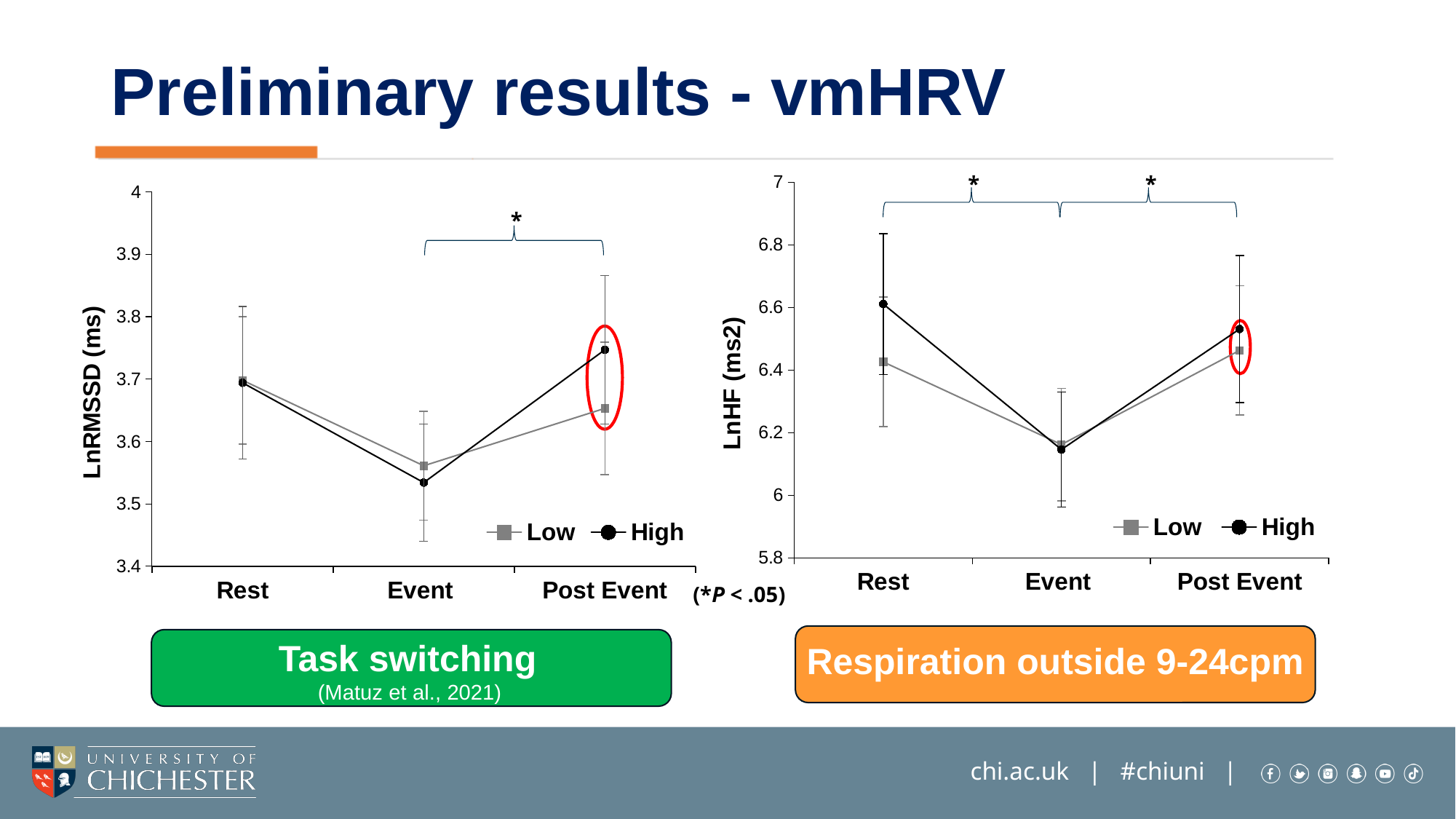
In the right chart (LnHF), at which category is the High series highest? Rest In the left chart (LnRMSSD), at Post Event, which series has the larger value, Low or High? High How many series does the legend of the right chart (LnHF) list? 2 How many categories are shown on the x axis of the left chart (LnRMSSD)? 3 What kind of chart is the left chart (LnRMSSD)? line chart In the right chart (LnHF), at which category is the Low series lowest? Event In the right chart (LnHF), at Rest, which series has the larger value, Low or High? High In the left chart (LnRMSSD), at which category is the High series highest? Post Event In the right chart (LnHF), do the values for the High series rise or fall from Rest to Event? fall In the right chart (LnHF), is the High value at Rest greater or less than 6.4? greater In the left chart (LnRMSSD), at which category is the High series lowest? Event In the left chart (LnRMSSD), is the High value at Event greater or less than 3.6? less